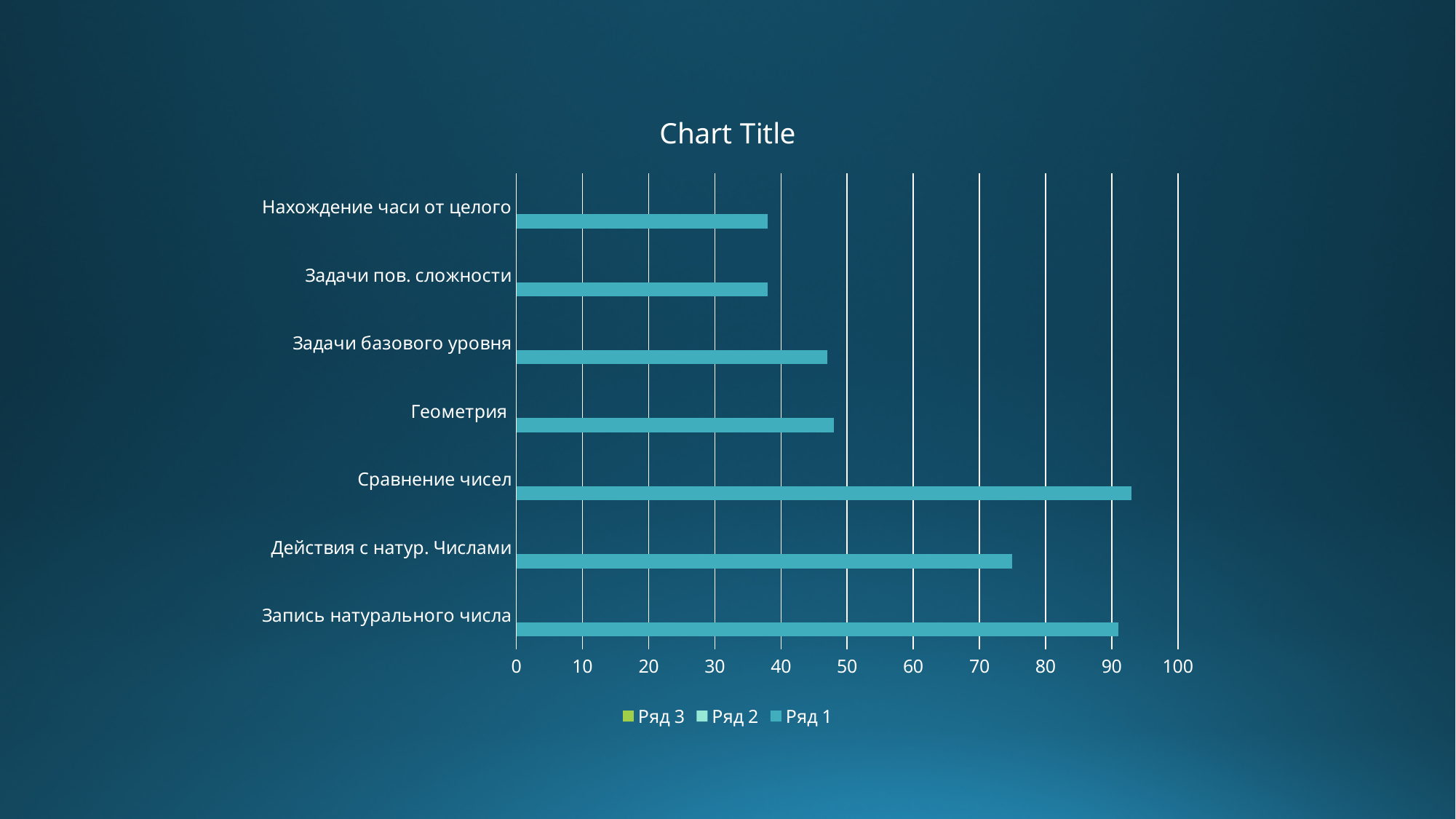
What is the highest value shown on the horizontal axis? 100 Which is larger, the value for Действия с натур. Числами or the value for Геометрия? Действия с натур. Числами Is the value for Запись натурального числа greater or less than 80? greater Is the value for Нахождение части от целого greater or less than 40? less Which is larger, the value for Сравнение чисел or the value for Задачи пов. сложности? Сравнение чисел Is the value for Действия с натур. Числами greater or less than 80? less How many series does the legend list? 3 What kind of chart is shown on the slide? bar chart How many categories are plotted on the chart? 7 What is the title of the chart? Chart Title